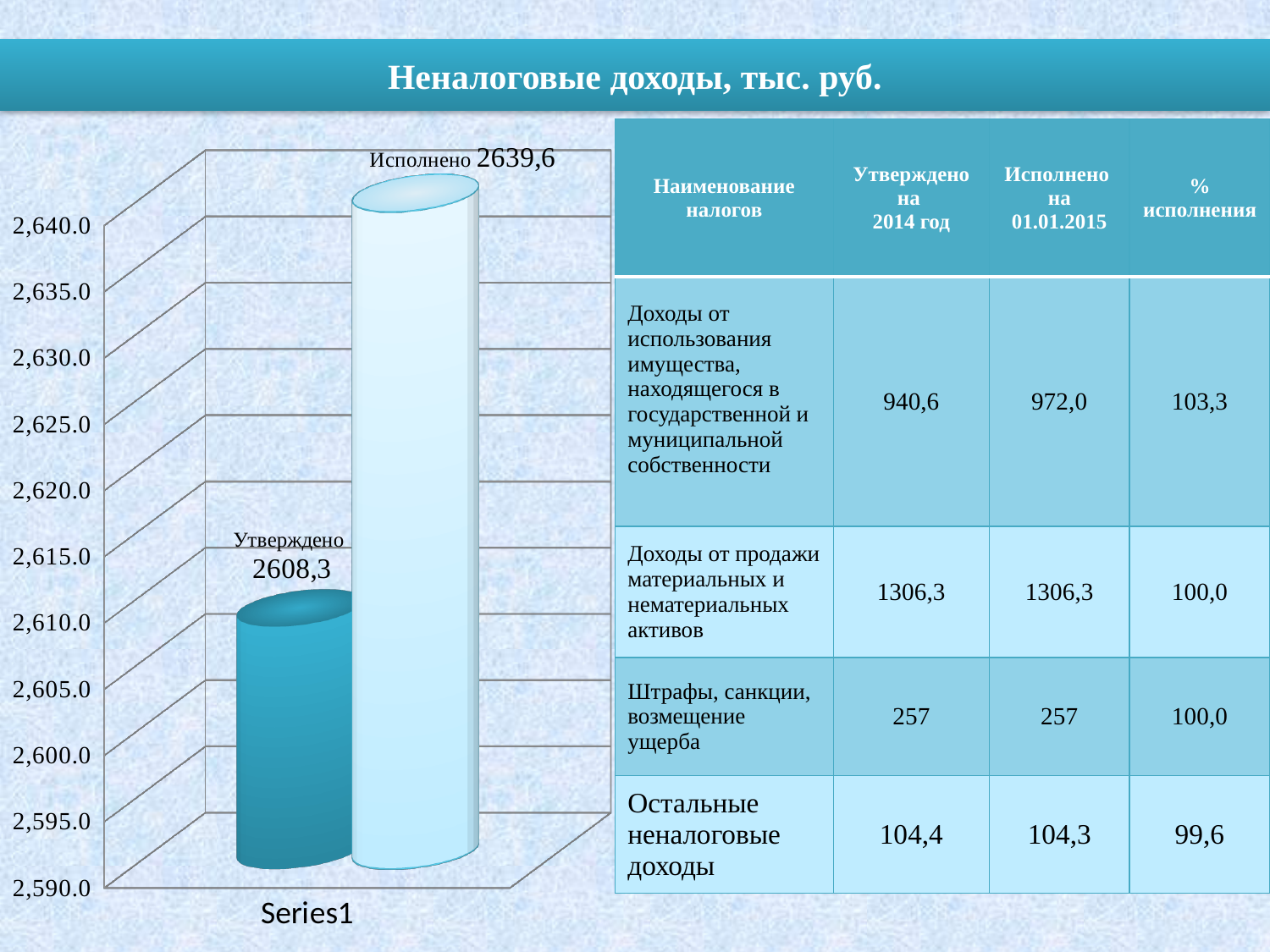
Which bar in the chart has the lowest value? Утверждено What is the difference between the 'Исполнено' and 'Утверждено' values in the chart? 31,3 What type of chart is shown on the slide? bar chart What value is shown for the 'Утверждено' bar in the chart? 2608,3 Is the value of the 'Утверждено' bar greater or less than 2,620.0? less Which bar in the chart is higher, 'Утверждено' or 'Исполнено'? Исполнено What is the lowest value shown on the chart's vertical axis? 2,590.0 Is the value of the 'Исполнено' bar greater or less than 2,630.0? greater Which bar in the chart has the highest value? Исполнено How many bars are plotted in the chart? 2 What is the title of the slide containing the chart? Неналоговые доходы, тыс. руб. What value is shown for the 'Исполнено' bar in the chart? 2639,6